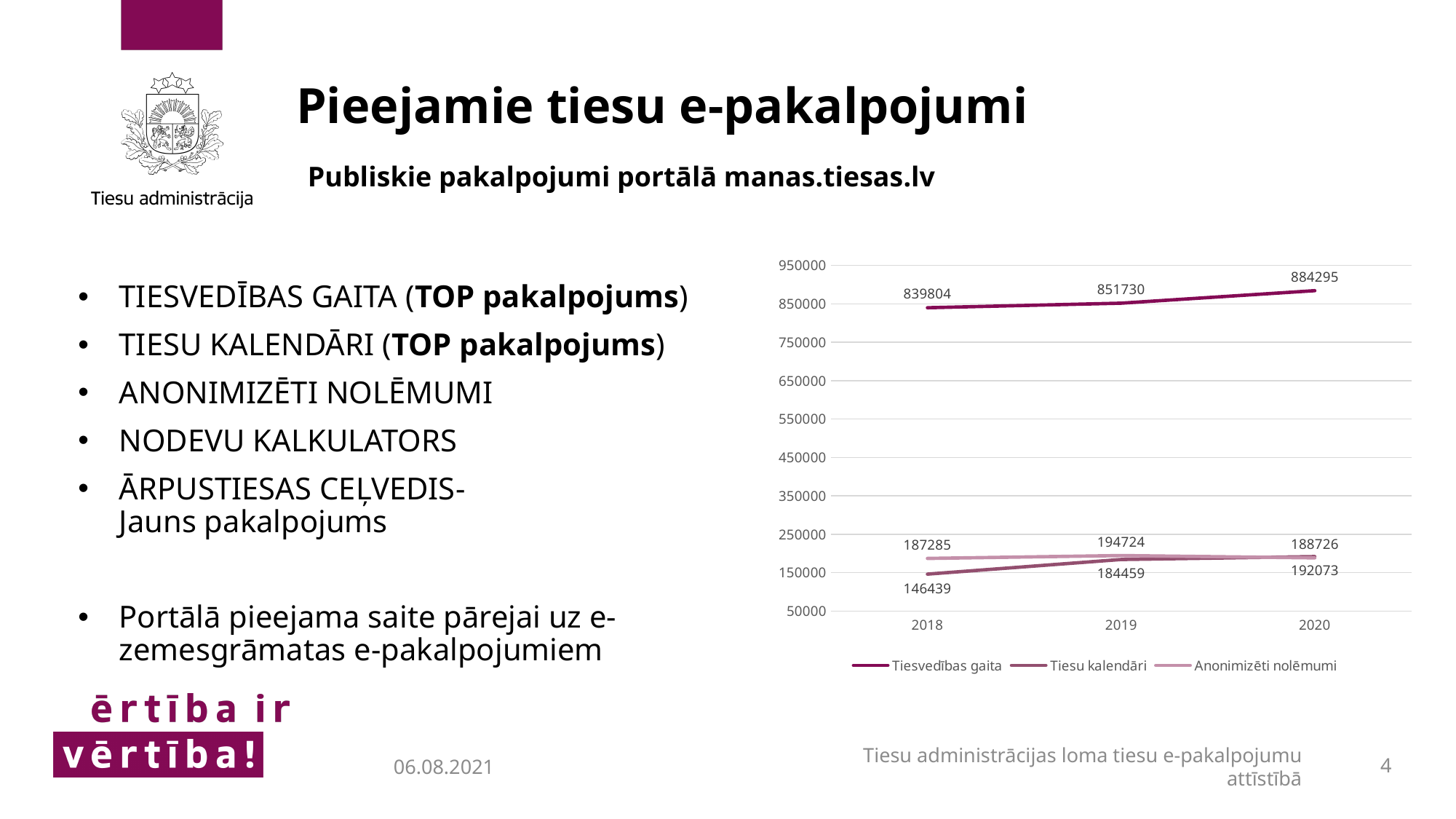
What is the value for Tiesvedības gaita in 2018? 839804 What type of chart is shown on the slide? line chart How many series does the chart legend list? 3 What is the value for Tiesu kalendāri in 2018? 146439 How many years are plotted on the x axis of the chart? 3 What is the value for Tiesvedības gaita in 2020? 884295 Does the Tiesvedības gaita series rise or fall from 2018 to 2020? rise What is the difference between the Tiesvedības gaita values for 2020 and 2018? 44491 Which series is plotted with the darkest line in the chart? Tiesvedības gaita In which year is Tiesvedības gaita highest? 2020 In which year is Tiesu kalendāri lowest? 2018 What is the value for Anonimizēti nolēmumi in 2019? 194724